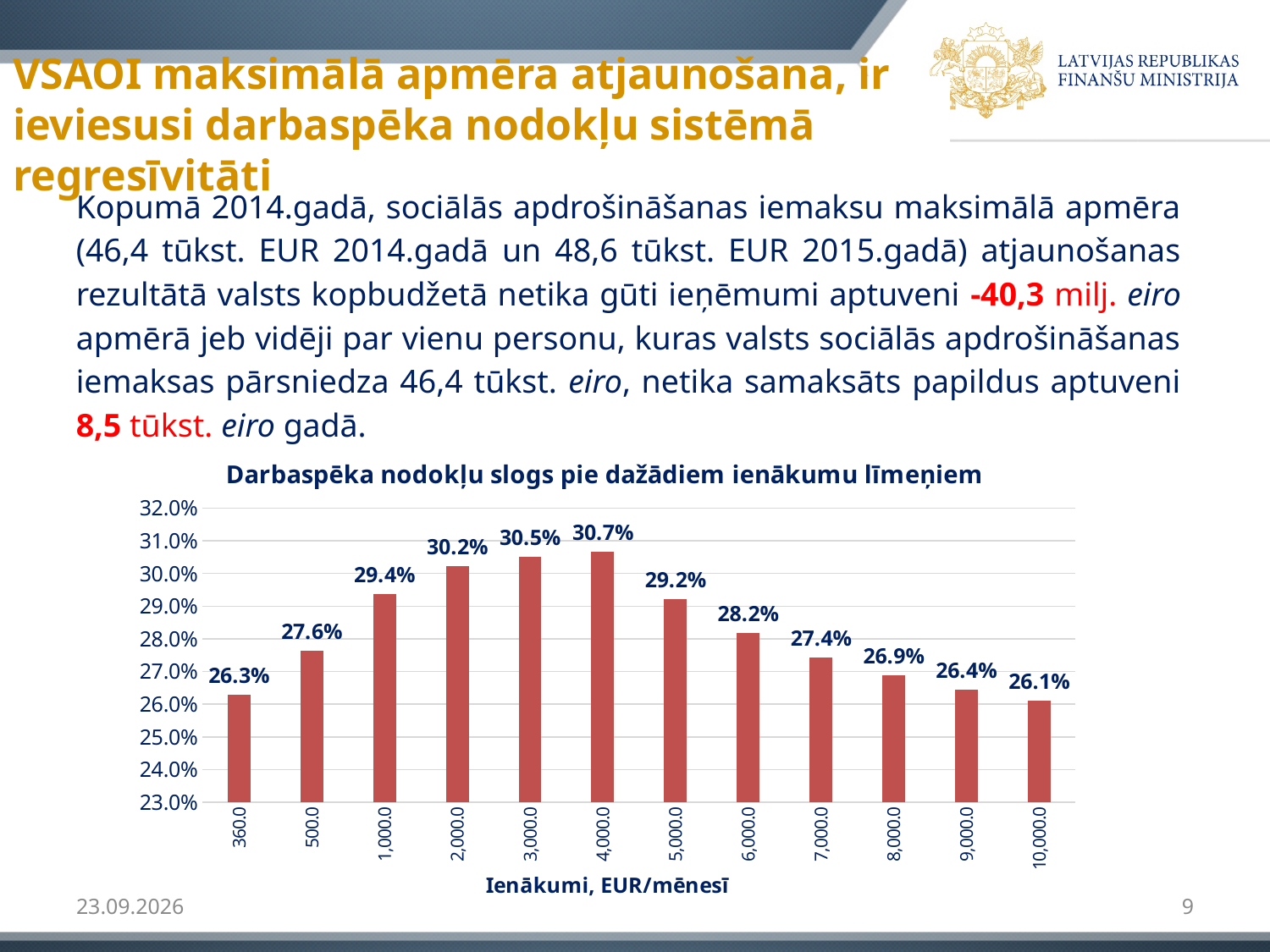
What is the difference between the values for 4,000.0 and 10,000.0? 4.6% What is the value for the 4,000.0 income level? 30.7% What is the value for the 360.0 income level? 26.3% Which is larger, the value for 1,000.0 or the value for 5,000.0? 1,000.0 Is the value for 8,000.0 greater or less than 27.0%? less What is the value for the 7,000.0 income level? 27.4% Which income level has the lowest value? 10,000.0 What kind of chart is shown on the slide? bar chart How many income levels are shown on the x axis? 12 What is the title of the chart? Darbaspēka nodokļu slogs pie dažādiem ienākumu līmeņiem What is the difference between the values for 2,000.0 and 500.0? 2.6% Which income level has the highest value? 4,000.0